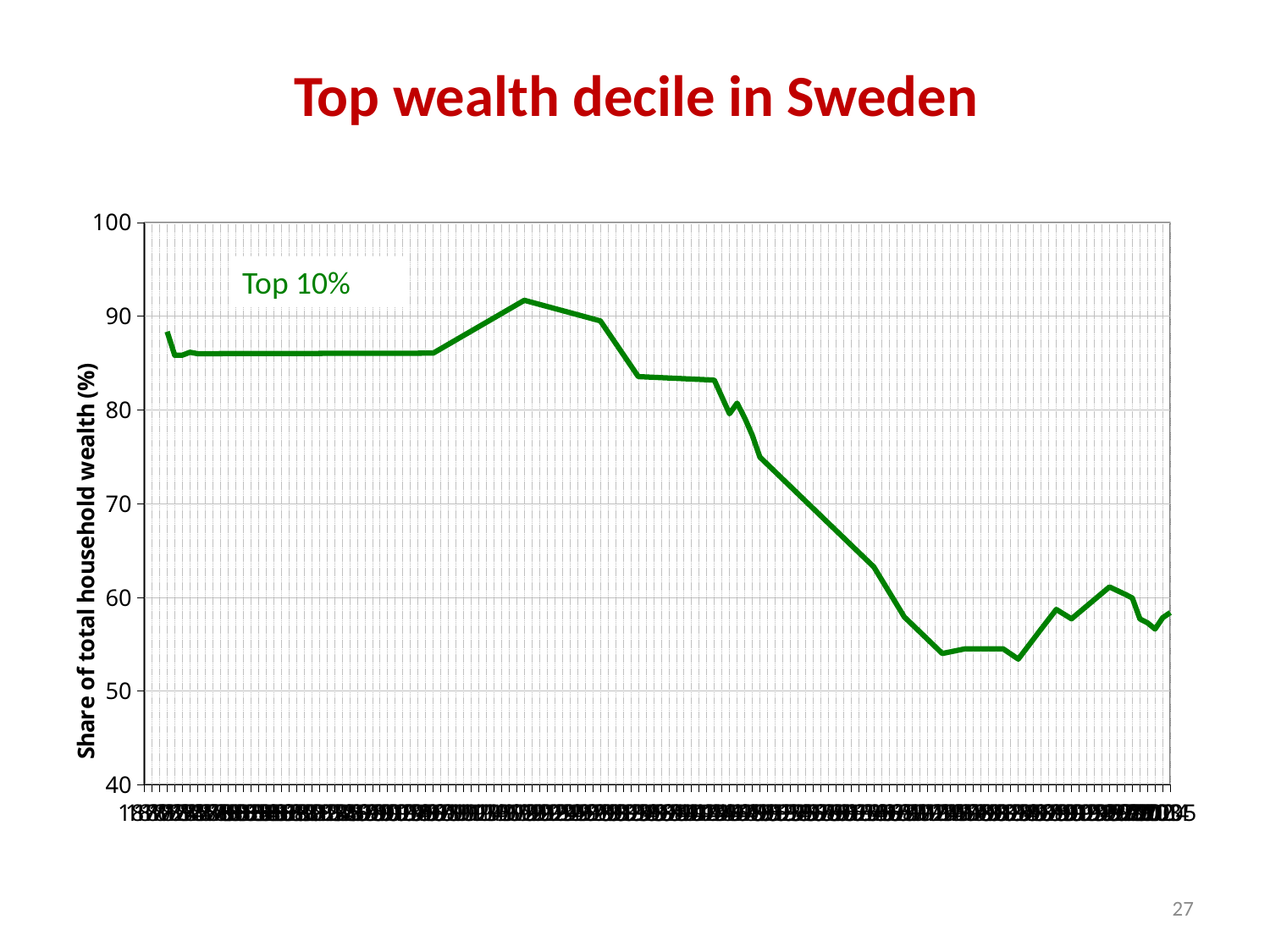
Which is larger, the value at the left end of the line or the value at the right end of the line? the left end What is the highest value shown on the y axis? 100 What is the title of the chart? Top wealth decile in Sweden Is the lowest value reached by the Top 10% line greater or less than 60? less Is the highest value reached by the Top 10% line greater or less than 90? greater What kind of chart is shown on the slide? line chart Overall, does the Top 10% line rise or fall from the left end to the right end of the chart? fall Is the lowest value reached by the Top 10% line greater or less than 50? greater How many series are plotted on the chart? 1 What label is shown next to the green line? Top 10%